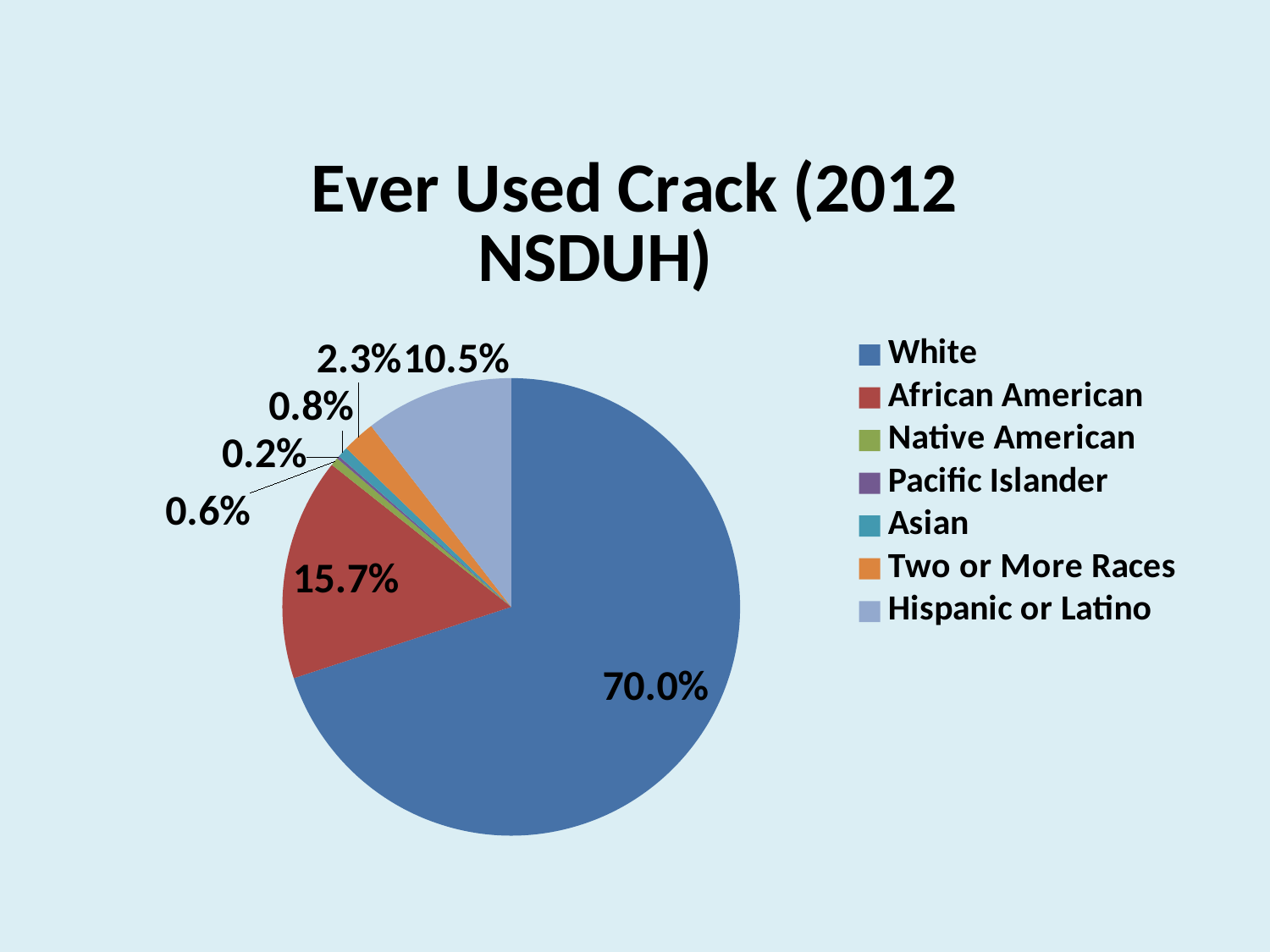
What is the title of the chart? Ever Used Crack (2012 NSDUH) Which category has the largest slice of the pie? White What share of the pie is Hispanic or Latino? 10.5% How many categories does the legend list? 7 Which is larger, the Asian share or the Native American share? Asian What type of chart is shown on the slide? pie chart What share of the pie is Two or More Races? 2.3% What is the difference between the White share and the African American share? 54.3% What share of the pie is Pacific Islander? 0.2% Which category has the smallest slice of the pie? Pacific Islander